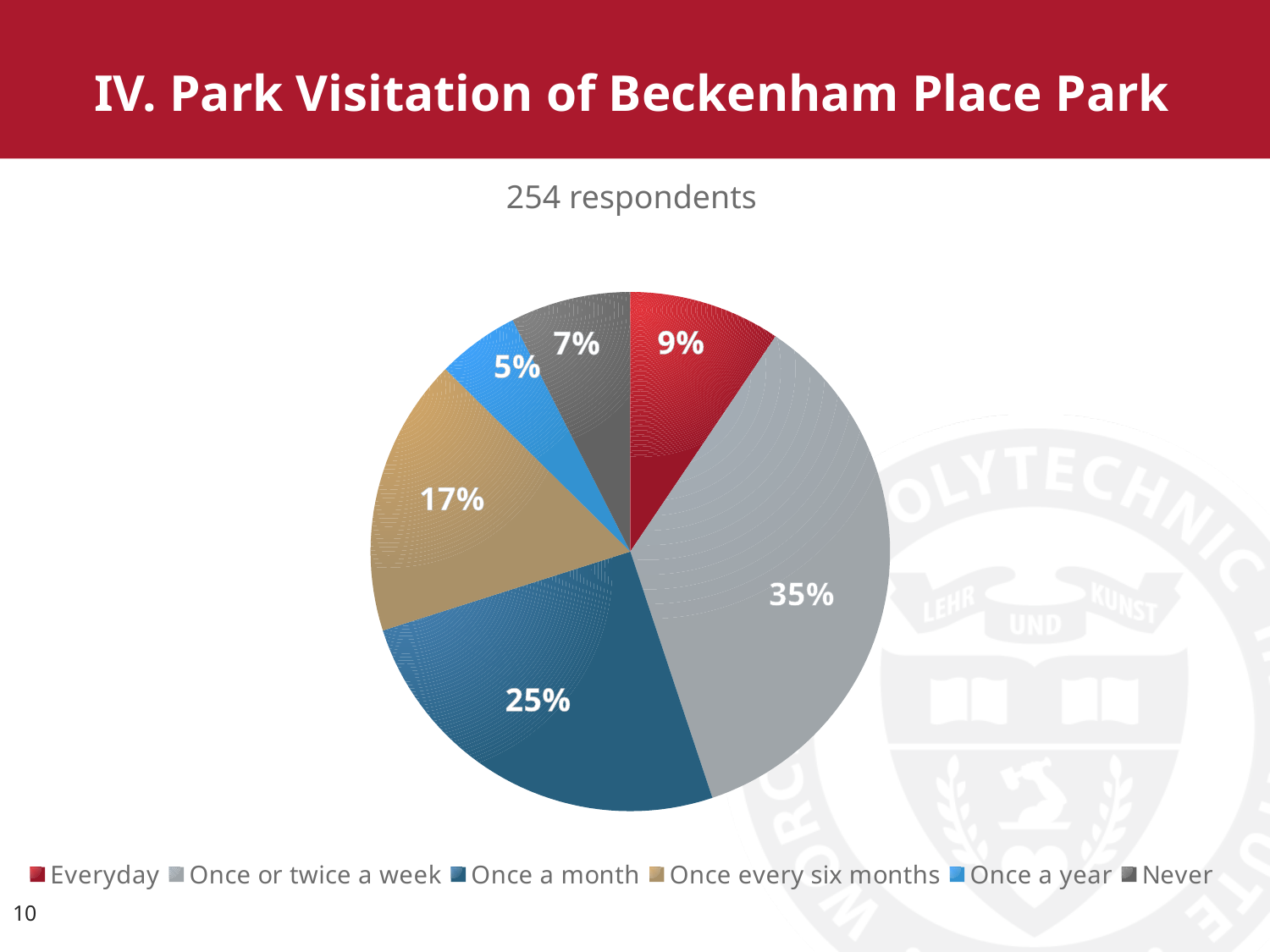
What is the difference in percentage points between 'Once or twice a week' and 'Once a month'? 10 How many respondents does the chart represent, according to the text above it? 254 How many categories does the pie chart have? 6 Which visitation frequency has the smallest share of respondents? Once a year Which is larger: the share for 'Everyday' or the share for 'Never'? Everyday Which visitation frequency has the largest share of respondents? Once or twice a week What colour is the 'Once every six months' slice? Tan/gold What share of respondents never visit the park? 7% What percentage of respondents visit once every six months? 17% What kind of chart is shown on the slide? Pie chart What share of respondents visit the park once or twice a week? 35% What percentage of respondents visit the park everyday? 9%